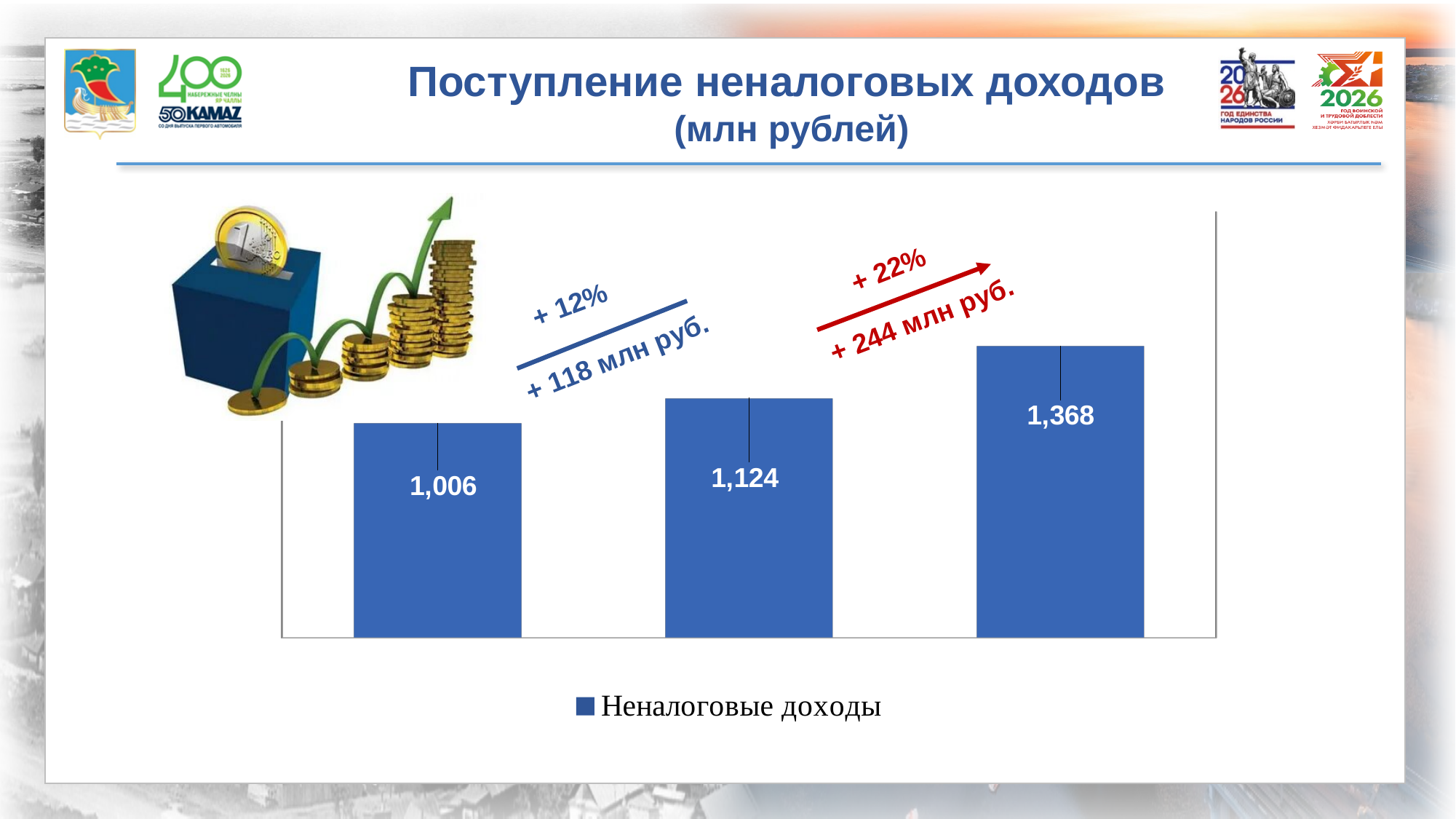
What is the value shown on the middle bar of the chart? 1,124 Do the values rise or fall from left to right across the bars? Rise Which bar has the highest value? The rightmost bar (1,368) What is the difference between the middle bar and the leftmost bar? 118 How many series does the legend list? 1 What kind of chart is shown on the slide? Bar chart Which bar has the lowest value? The leftmost bar (1,006) Which is larger, the leftmost bar or the middle bar? The middle bar (1,124) What is the value shown on the rightmost bar of the chart? 1,368 What is the difference between the rightmost bar and the middle bar? 244 How many bars are plotted in the chart? 3 What is the value shown on the leftmost bar of the chart? 1,006